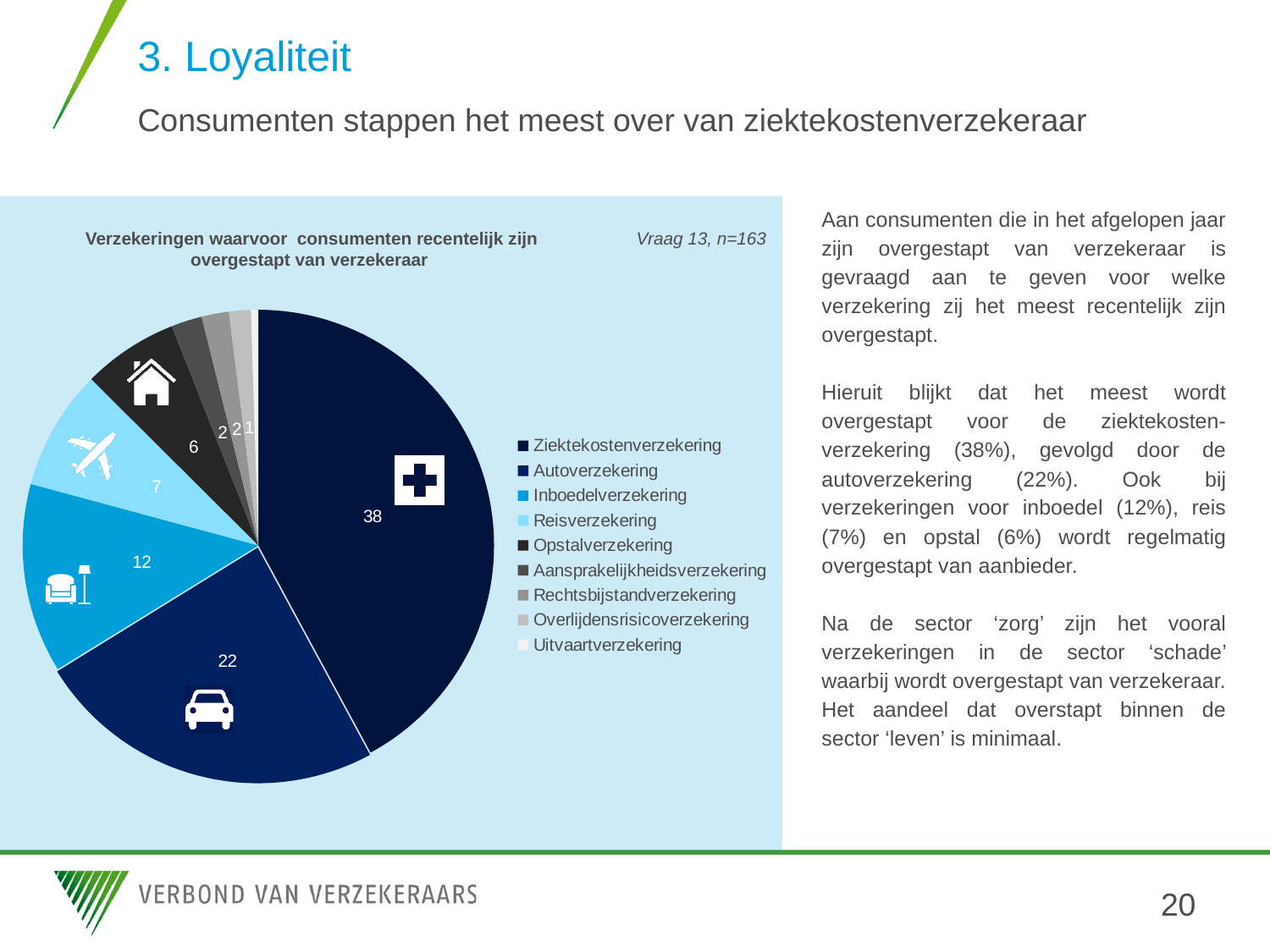
What sample size (n) is stated next to the chart title? n=163 Which is larger in the pie chart: Inboedelverzekering or Reisverzekering? Inboedelverzekering What is the value shown for Opstalverzekering in the pie chart? 6 Which category has the largest slice in the pie chart? Ziektekostenverzekering What kind of chart is shown on the slide? pie chart What is the value shown for Ziektekostenverzekering in the pie chart? 38 How many categories does the legend of the pie chart list? 9 What is the title of the pie chart? Verzekeringen waarvoor consumenten recentelijk zijn overgestapt van verzekeraar What is the value shown for Inboedelverzekering in the pie chart? 12 What is the value shown for Autoverzekering in the pie chart? 22 What is the value shown for Reisverzekering in the pie chart? 7 What is the difference between the values for Ziektekostenverzekering and Autoverzekering? 16